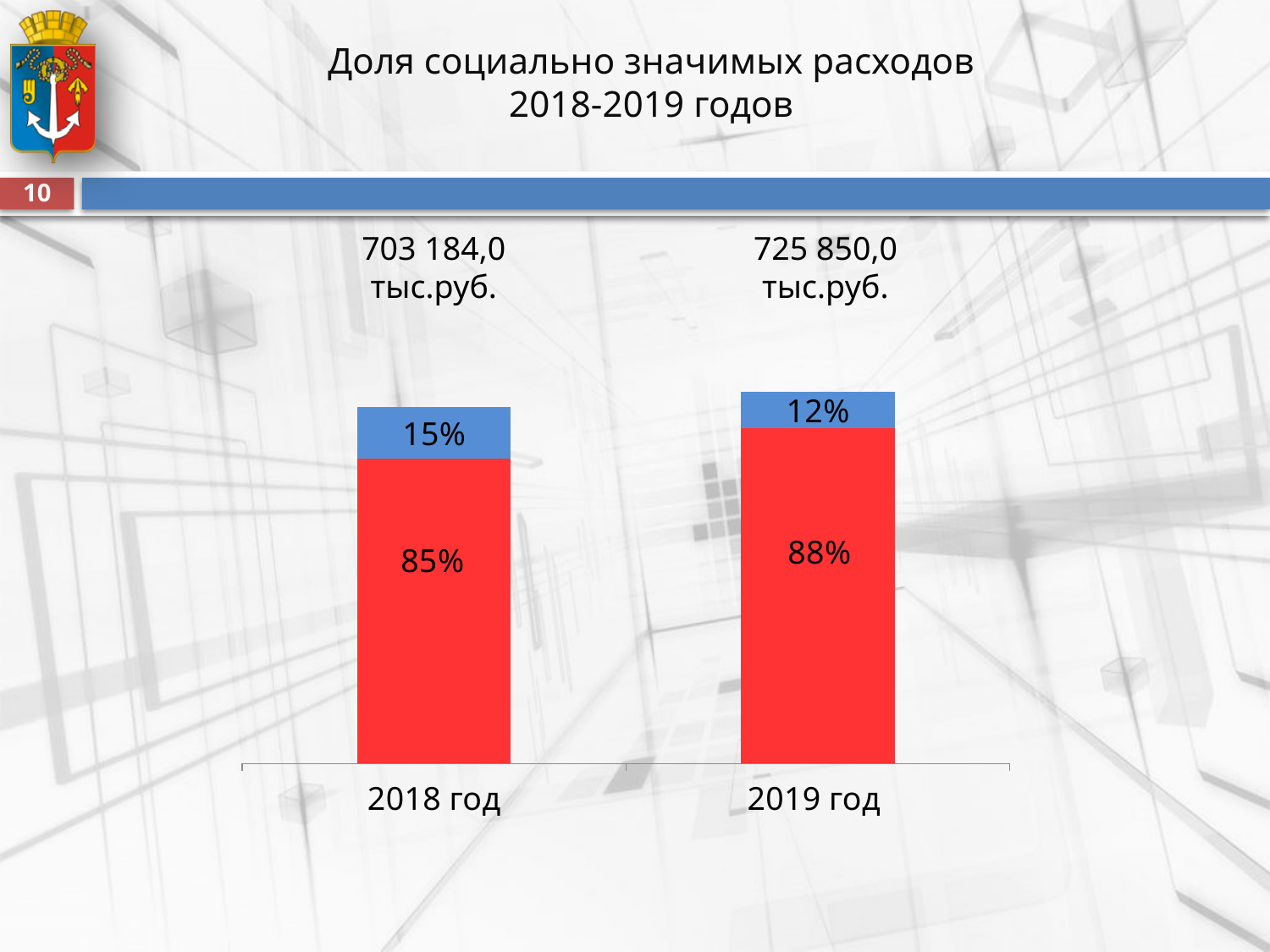
How many categories (years) are shown on the x axis? 2 What is the value of the blue segment for 2018 год? 15% By how many percentage points does the red segment for 2019 год exceed the red segment for 2018 год? 3 percentage points In which year is the red segment the highest? 2019 год What kind of chart is shown on the slide? Stacked bar chart What is the value of the red segment for 2018 год? 85% Does the red segment rise or fall from 2018 год to 2019 год? Rises What is the title of the slide containing the chart? Доля социально значимых расходов 2018-2019 годов What amount in тыс.руб. is shown above the bar for 2018 год? 703 184,0 тыс.руб. Which year has the larger blue segment, 2018 год or 2019 год? 2018 год What amount in тыс.руб. is shown above the bar for 2019 год? 725 850,0 тыс.руб. What is the value of the blue segment for 2019 год? 12%